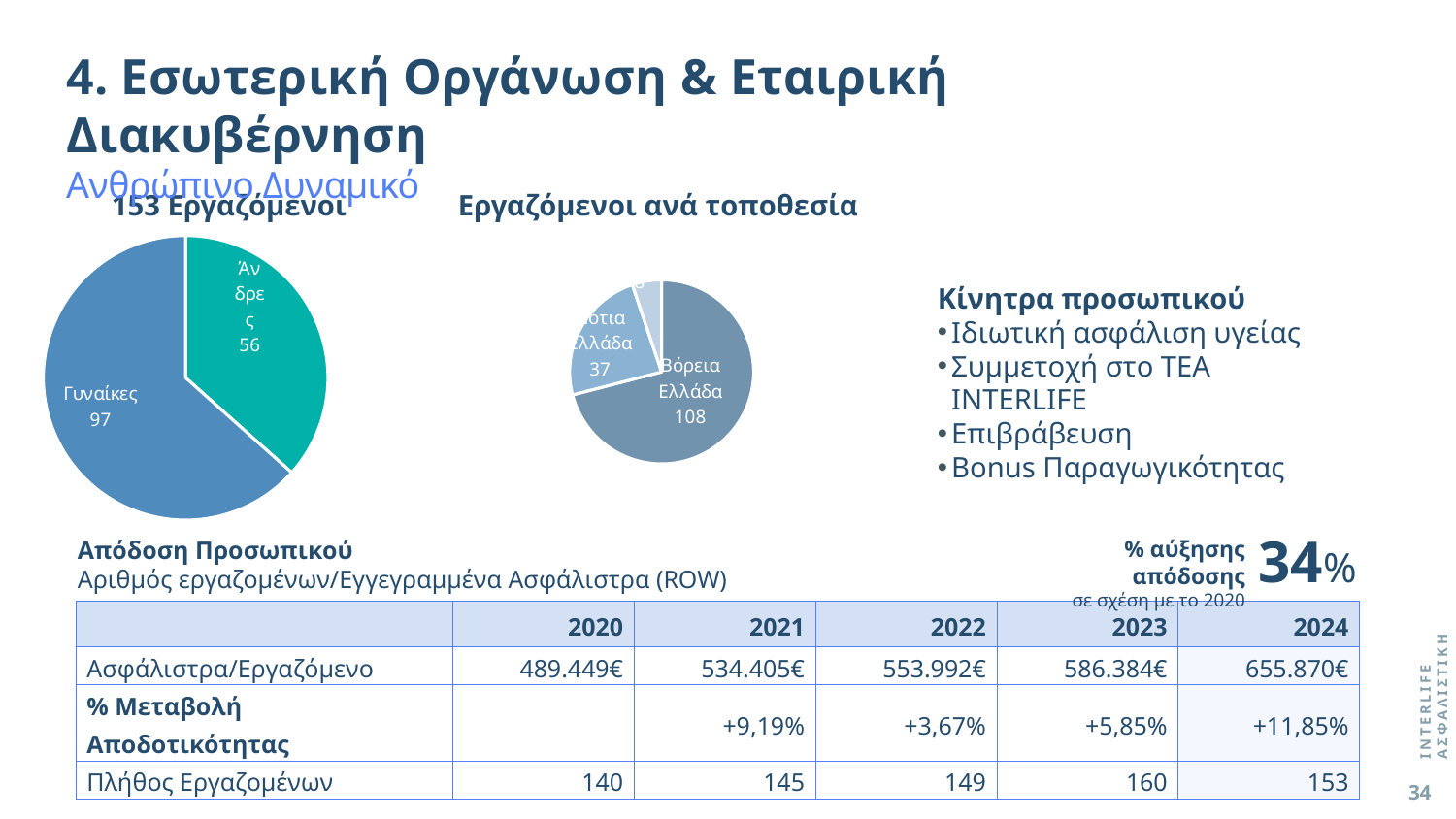
What kind of chart is the one titled '153 Εργαζόμενοι'? pie chart In the pie chart titled '153 Εργαζόμενοι', what is the value for Γυναίκες? 97 In the pie chart titled '153 Εργαζόμενοι', which category has the larger slice? Γυναίκες In the pie chart titled '153 Εργαζόμενοι', what is the value for Άνδρες? 56 In the pie chart titled 'Εργαζόμενοι ανά τοποθεσία', what is the value for Βόρεια Ελλάδα? 108 What is the title of the pie chart on the right of the two pie charts? Εργαζόμενοι ανά τοποθεσία In the pie chart titled 'Εργαζόμενοι ανά τοποθεσία', what is the difference between Βόρεια Ελλάδα and Νότια Ελλάδα? 71 In the pie chart titled 'Εργαζόμενοι ανά τοποθεσία', which location has the largest slice? Βόρεια Ελλάδα In the pie chart titled '153 Εργαζόμενοι', what is the difference between the values for Γυναίκες and Άνδρες? 41 In the pie chart titled 'Εργαζόμενοι ανά τοποθεσία', what is the value for Νότια Ελλάδα? 37 In the pie chart titled 'Εργαζόμενοι ανά τοποθεσία', is the value for Βόρεια Ελλάδα larger or smaller than the value for Νότια Ελλάδα? larger In the pie chart titled '153 Εργαζόμενοι', how many slices are there? 2